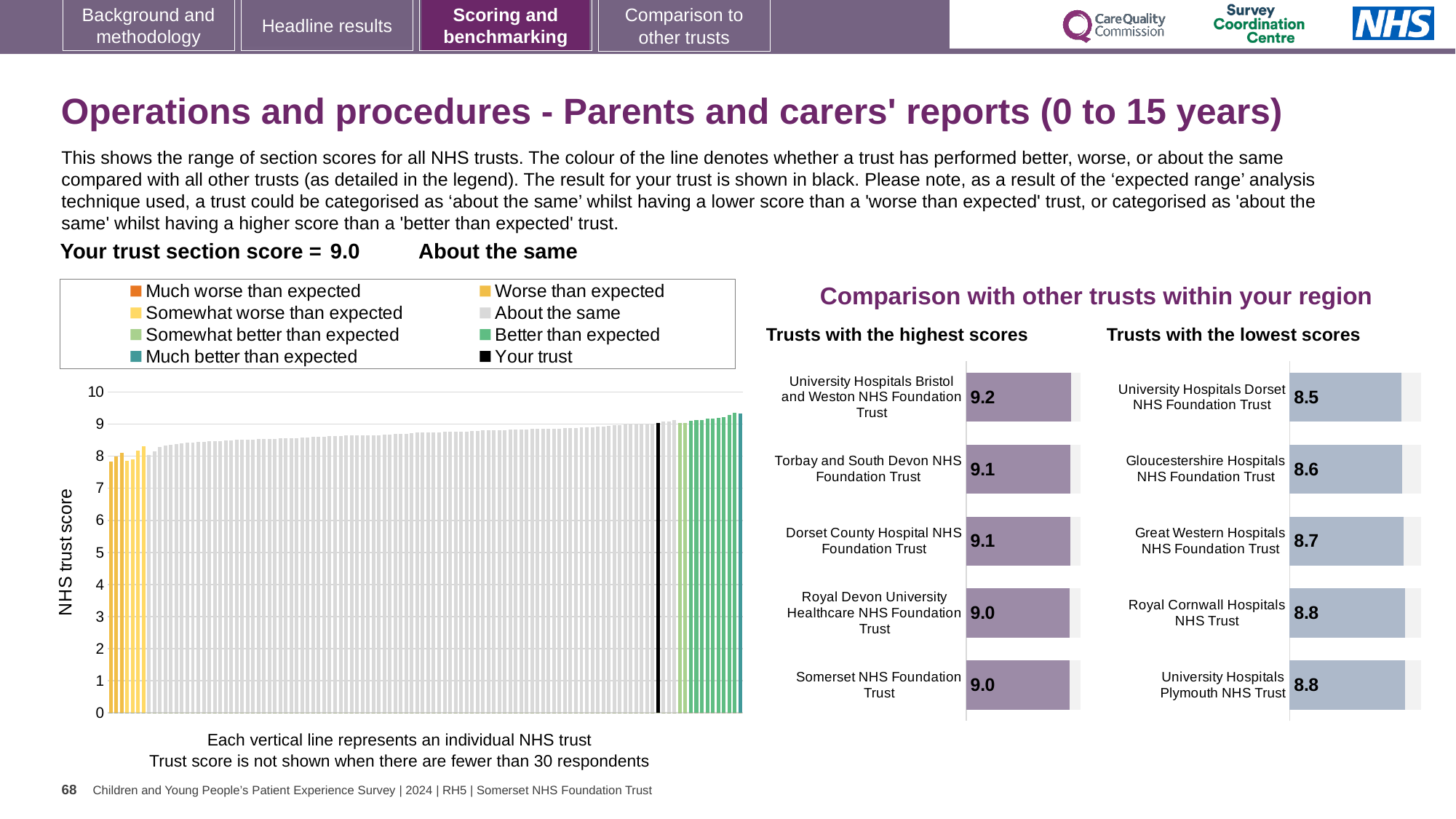
In the 'Trusts with the lowest scores' chart, what is the difference between the scores of Royal Cornwall Hospitals NHS Trust and University Hospitals Dorset NHS Foundation Trust? 0.3 In the 'Trusts with the highest scores' chart, what is the score for University Hospitals Bristol and Weston NHS Foundation Trust? 9.2 In the 'Trusts with the lowest scores' chart, what is the score for Gloucestershire Hospitals NHS Foundation Trust? 8.6 In the 'Trusts with the lowest scores' chart, which has the higher score: Great Western Hospitals NHS Foundation Trust or Gloucestershire Hospitals NHS Foundation Trust? Great Western Hospitals NHS Foundation Trust How many trusts are listed in the 'Trusts with the lowest scores' chart? 5 What kind of chart is the large chart with the 'NHS trust score' axis? Bar chart In the large 'NHS trust score' chart, do the bar values rise or fall from left to right along the x axis? Rise In the 'Trusts with the highest scores' chart, which trust has the highest score? University Hospitals Bristol and Weston NHS Foundation Trust In the 'Trusts with the highest scores' chart, what is the difference between the scores of University Hospitals Bristol and Weston NHS Foundation Trust and Somerset NHS Foundation Trust? 0.2 In the 'Trusts with the highest scores' chart, what is the score for Torbay and South Devon NHS Foundation Trust? 9.1 In the 'Trusts with the lowest scores' chart, which trust has the lowest score? University Hospitals Dorset NHS Foundation Trust How many entries does the legend of the large 'NHS trust score' chart list? 8